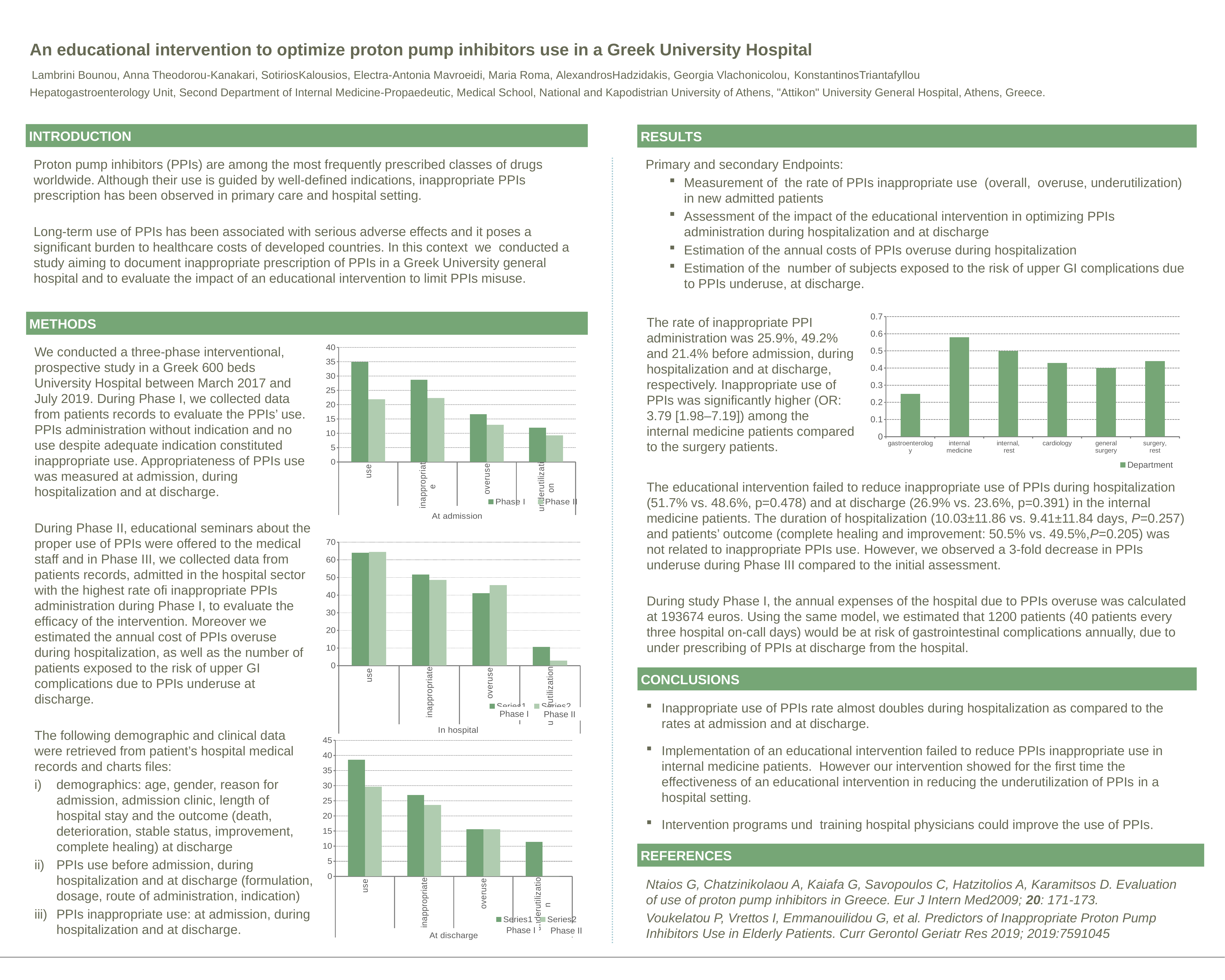
In the 'At discharge' chart, is the Phase I value for 'use' greater or less than 35? greater In the 'At admission' chart, how many categories are shown on the x axis? 4 In the 'At admission' chart, is the Phase I value for 'use' greater or less than 30? greater In the 'In hospital' chart, which category has the lowest Phase II value? underutilization In the 'Department' chart, which department has the highest value? internal medicine In the 'In hospital' chart, which is larger for 'overuse': Phase I or Phase II? Phase II In the 'At admission' chart, which category has the highest Phase I value? use In the 'At admission' chart, is the Phase II value for 'underutilization' greater or less than 10? less In the 'At discharge' chart, which is larger for 'use': Phase I or Phase II? Phase I In the 'Department' chart, which department has the lowest value? gastroenterology In the 'Department' chart, how many departments are shown on the x axis? 6